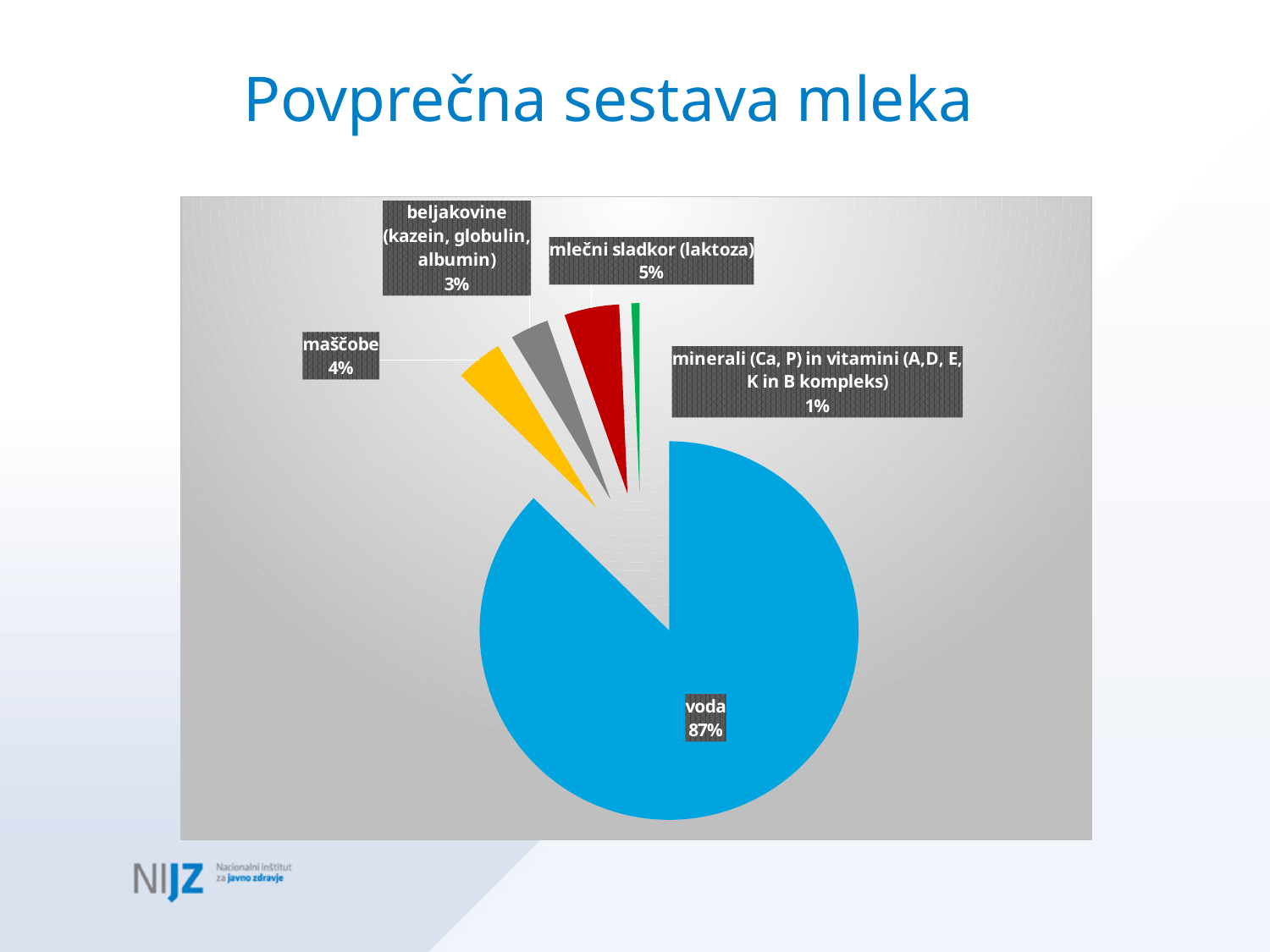
How many categories are shown in the pie chart? 5 What is the value shown for minerali (Ca, P) in vitamini (A,D, E, K in B kompleks)? 1% Which is larger, the share of maščobe or the share of mlečni sladkor (laktoza)? mlečni sladkor (laktoza) What is the value shown for beljakovine (kazein, globulin, albumin)? 3% Which category has the largest slice of the pie? voda What kind of chart is shown on the slide? pie chart Which category has the smallest slice of the pie? minerali (Ca, P) in vitamini (A,D, E, K in B kompleks) What is the value shown for maščobe? 4% What is the value shown for mlečni sladkor (laktoza)? 5% What is the title of the slide containing the chart? Povprečna sestava mleka What share of the pie does voda (water) account for? 87% What is the difference between the share of mlečni sladkor (laktoza) and the share of beljakovine? 2%